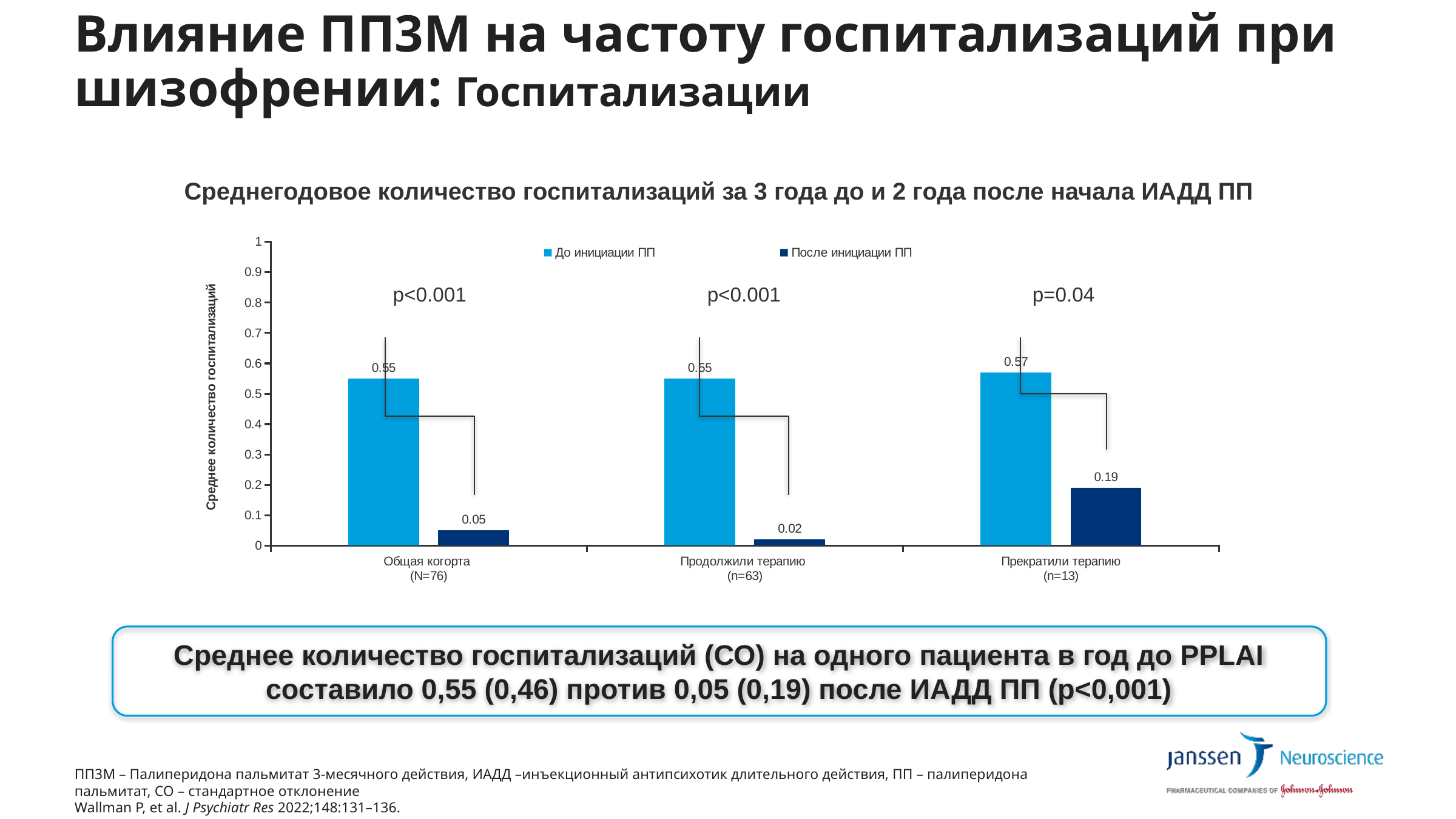
What is the difference between the 'До инициации ПП' and 'После инициации ПП' values in the 'Общая когорта (N=76)' group? 0.5 What is the value for 'После инициации ПП' in the 'Прекратили терапию (n=13)' group? 0.19 Is the 'После инициации ПП' value for 'Прекратили терапию (n=13)' greater or less than 0.1? greater Which is larger in the 'Прекратили терапию (n=13)' group: the value before or after initiation of ПП? До инициации ПП What is the value for 'До инициации ПП' in the 'Общая когорта (N=76)' group? 0.55 What is the value for 'После инициации ПП' in the 'Продолжили терапию (n=63)' group? 0.02 Which group has the lowest value for 'После инициации ПП'? Продолжили терапию (n=63) What kind of chart is shown on the slide? bar chart What p-value is shown above the 'Прекратили терапию (n=13)' group? p=0.04 How many series does the legend list? 2 Which group has the highest value for 'До инициации ПП'? Прекратили терапию (n=13) How many groups are shown on the x axis? 3